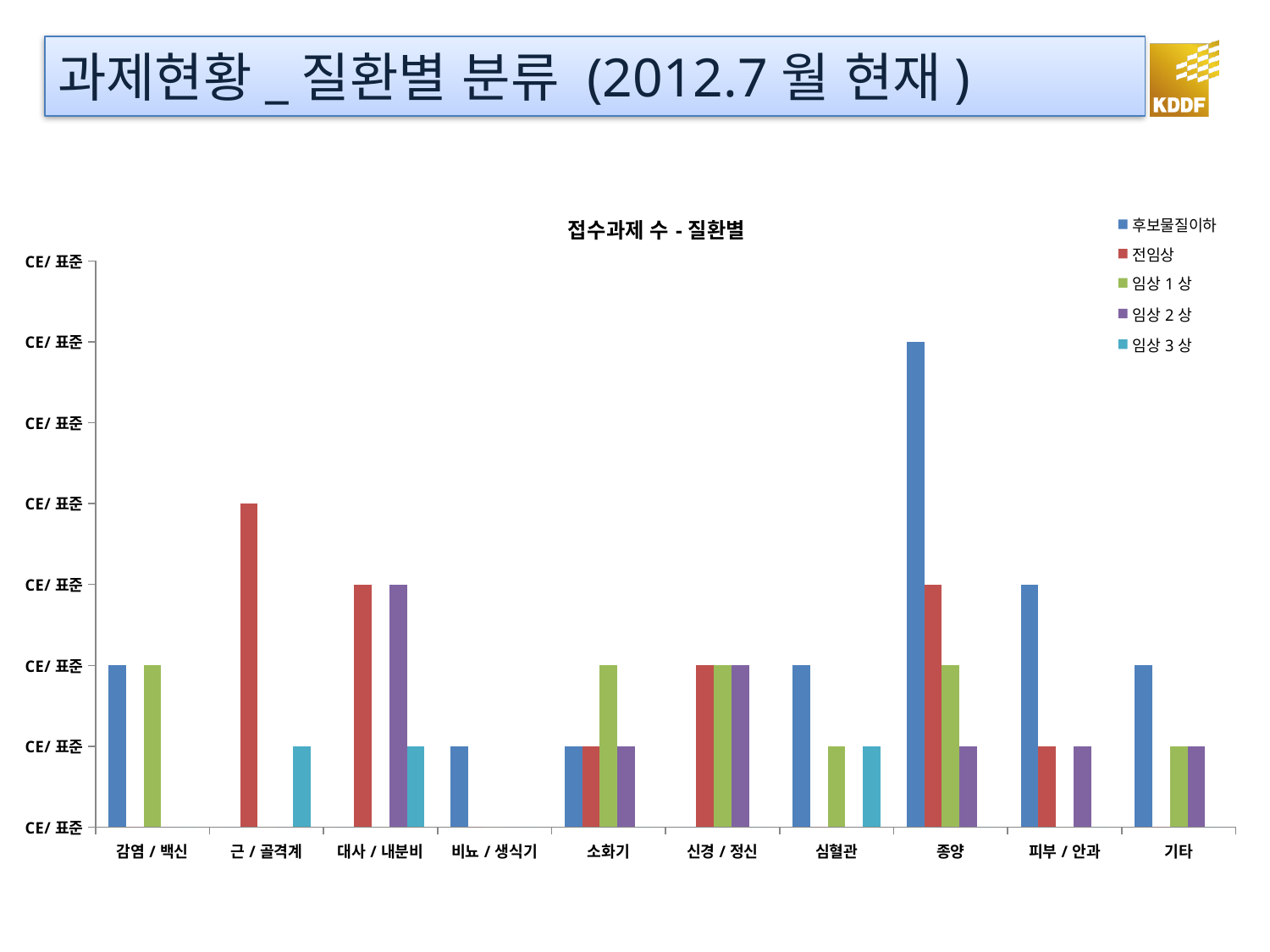
Which series has the tallest bar in the 종양 category? 후보물질이하 Which is larger, the 전임상 bar for 근 / 골격계 or for 대사 / 내분비? 근 / 골격계 What kind of chart is shown on the slide? bar chart Which is larger, the 임상 1 상 bar for 소화기 or for 기타? 소화기 How many series does the legend list? 5 How many categories are shown on the x axis? 10 What is the title of the chart? 접수과제 수 - 질환별 Which category has the tallest 임상 2 상 bar? 대사 / 내분비 Which is larger, the 후보물질이하 bar for 종양 or for 피부 / 안과? 종양 Which series is listed first in the legend? 후보물질이하 Which category has the tallest 전임상 bar? 근 / 골격계